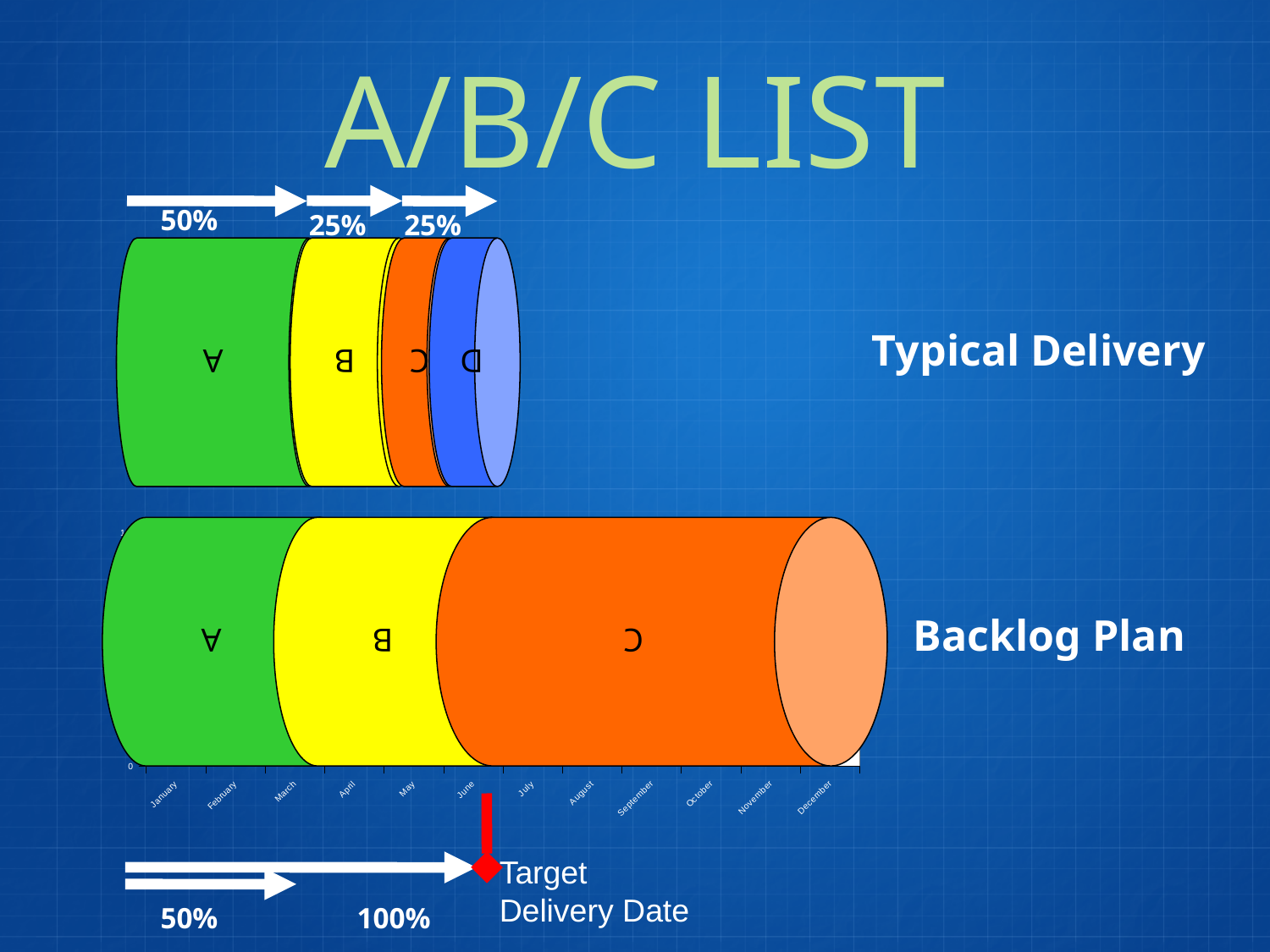
In the Backlog Plan chart, what colour is segment C? Orange In the Typical Delivery chart, which segment is the largest? A In the Typical Delivery chart, which segment is larger, A or B? A In the Backlog Plan chart, which segment is larger, A or C? C What kind of chart is the Backlog Plan chart? Bar chart In the Backlog Plan chart, which segment is the largest? C How many month labels appear on the x axis of the Backlog Plan chart? 12 In the Backlog Plan chart, which segment is shown in green? A In the Backlog Plan chart, how many labelled segments does the bar contain? 3 In the Typical Delivery chart, which segment is shown in blue? D In the Typical Delivery chart, how many labelled segments does the bar contain? 4